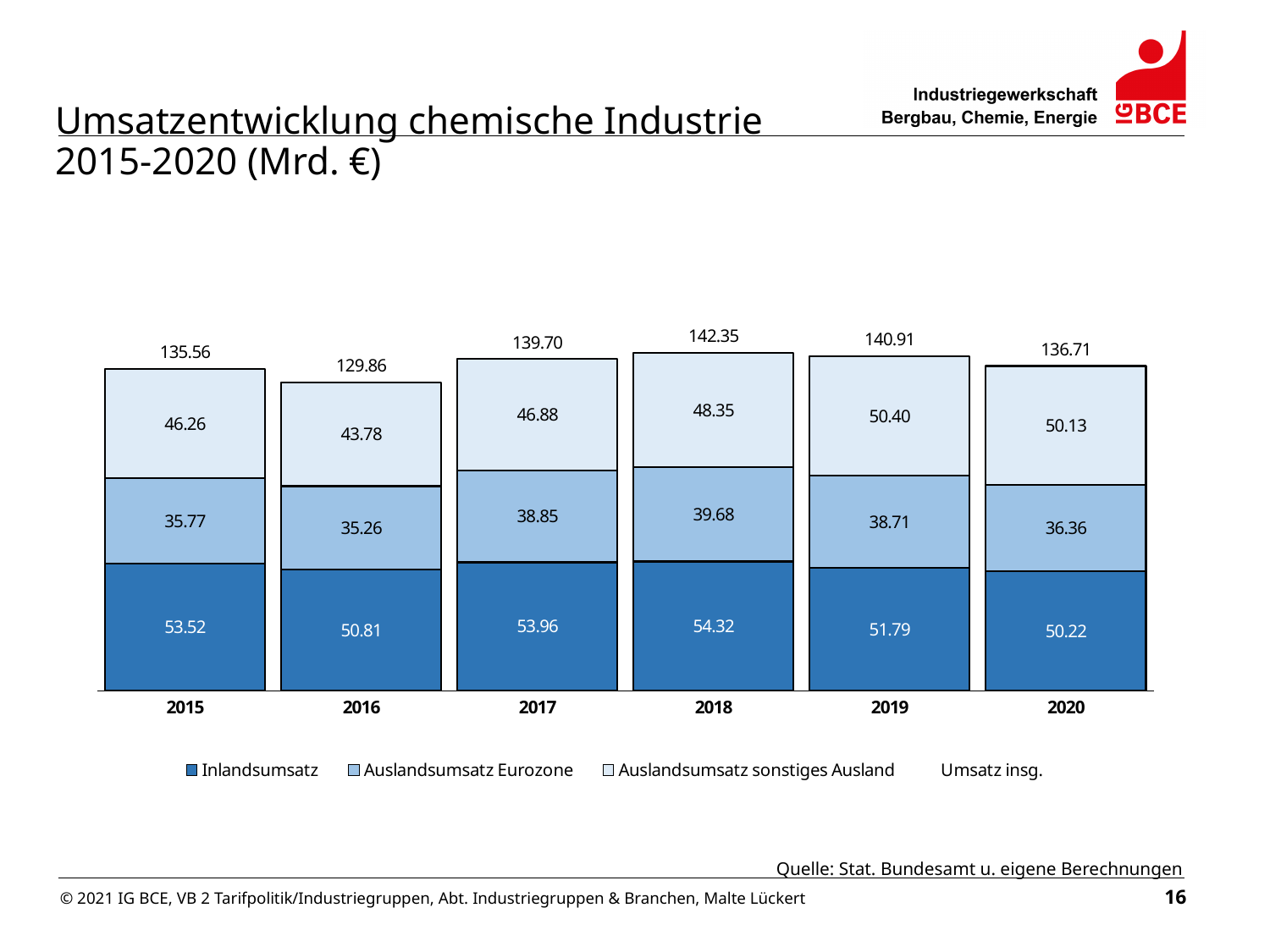
Which is larger, the Inlandsumsatz for 2015 or for 2020? 2015 What is the Inlandsumsatz value for 2018? 54.32 What kind of chart is shown on the slide? Stacked bar chart What is the difference between the total for 2018 and the total for 2016? 12.49 What is the total (Umsatz insg.) shown above the bar for 2017? 139.70 Which year has the lowest total Umsatz insg.? 2016 How many years are shown on the x axis? 6 Which year has the highest total Umsatz insg.? 2018 What is the Auslandsumsatz Eurozone value for 2016? 35.26 How many entries does the legend list? 4 Does the Auslandsumsatz sonstiges Ausland value rise or fall from 2016 to 2019? Rise What is the Auslandsumsatz sonstiges Ausland value for 2019? 50.40